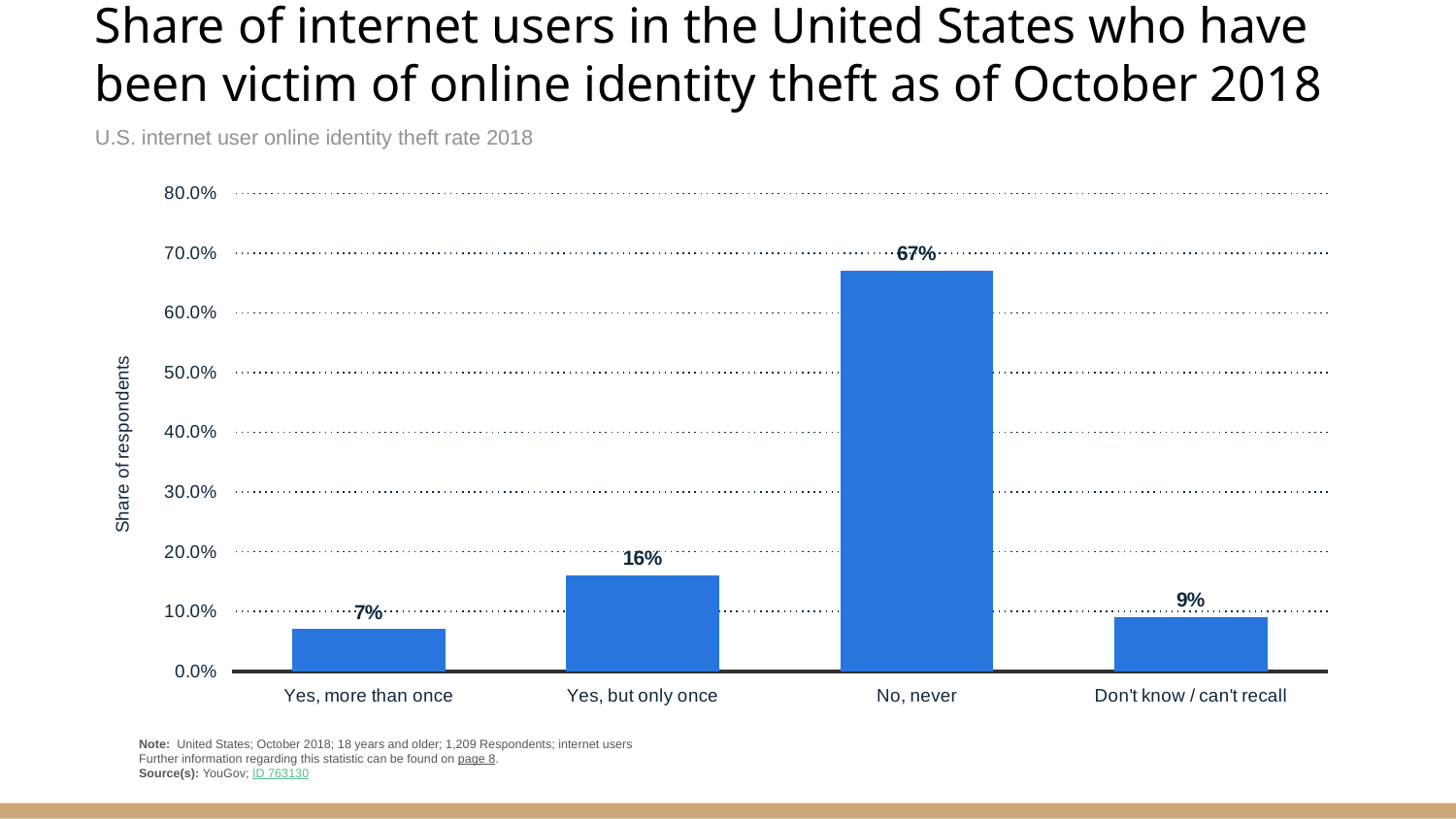
Which is larger: the share for "Yes, but only once" or the share for "Don't know / can't recall"? Yes, but only once What share of respondents answered "Yes, more than once"? 7% What share of respondents answered "No, never"? 67% Which response category has the highest share of respondents? No, never Which response category has the lowest share of respondents? Yes, more than once What type of chart is shown on the slide? Bar chart What share of respondents answered "Don't know / can't recall"? 9% What share of respondents answered "Yes, but only once"? 16% How many response categories are shown on the x axis? 4 What is the difference in percentage points between "Don't know / can't recall" and "Yes, more than once"? 2 What is the difference in percentage points between "No, never" and "Yes, but only once"? 51 Is the value for "No, never" greater or less than 60.0%? greater